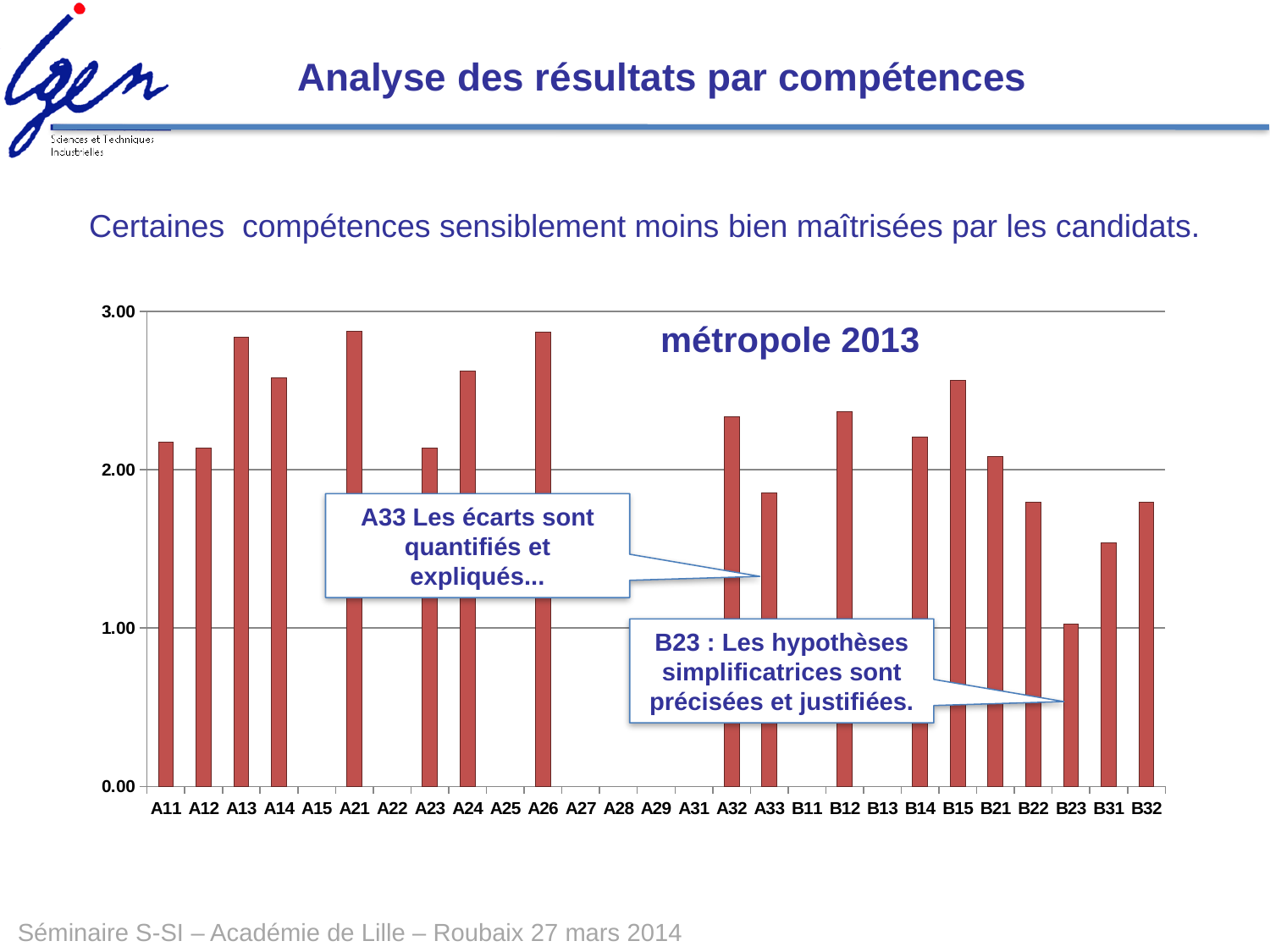
Is the value for A33 greater or less than 2.00? less What kind of chart is shown on the slide? bar chart Is the value for A13 greater or less than 2.00? greater How many category labels are shown on the x axis of the chart? 27 Is the value for B22 greater or less than 2.00? less Which is larger, the value for A12 or the value for A13? A13 Which competence does the callout 'Les écarts sont quantifiés et expliqués...' refer to? A33 Which is larger, the value for B23 or the value for B31? B31 Which category has the lowest bar in the chart? B23 What is the title shown inside the chart? métropole 2013